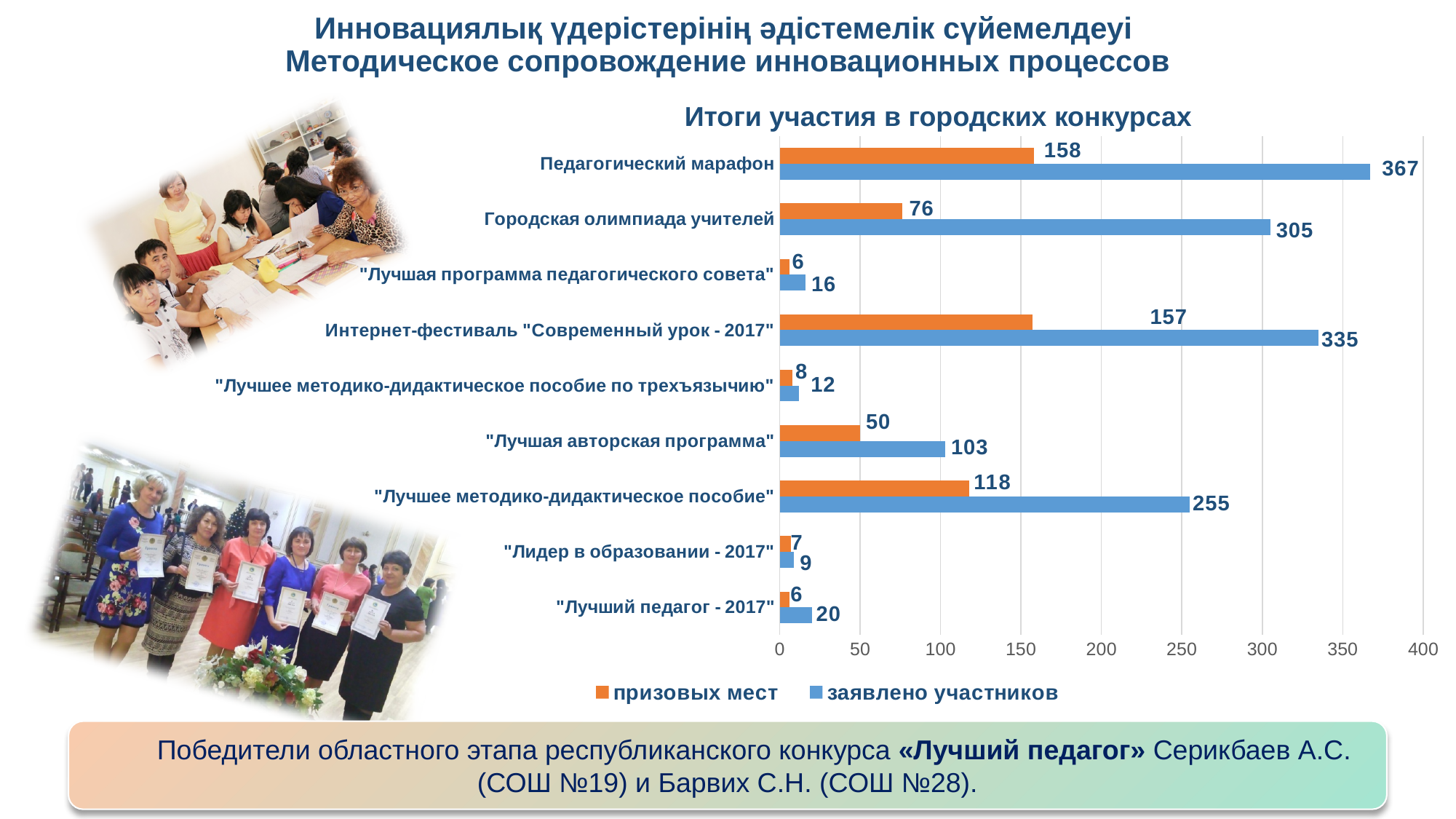
Is the value of заявлено участников for Городская олимпиада учителей greater or less than 300? greater How many categories (competitions) are shown in the chart? 9 What is the value of заявлено участников for "Лучшая авторская программа"? 103 What type of chart is shown on the slide? Bar chart What is the difference between заявлено участников and призовых мест for Интернет-фестиваль "Современный урок - 2017"? 178 How many prize places (призовых мест) were won in Городская олимпиада учителей? 76 How many participants were declared (заявлено участников) for Педагогический марафон? 367 Which is larger: призовых мест for Педагогический марафон or for "Лучшее методико-дидактическое пособие"? Педагогический марафон What is the title of the chart? Итоги участия в городских конкурсах Which category has the highest number of заявлено участников? Педагогический марафон How many series does the legend list? 2 Which category has the lowest number of заявлено участников? "Лидер в образовании - 2017"